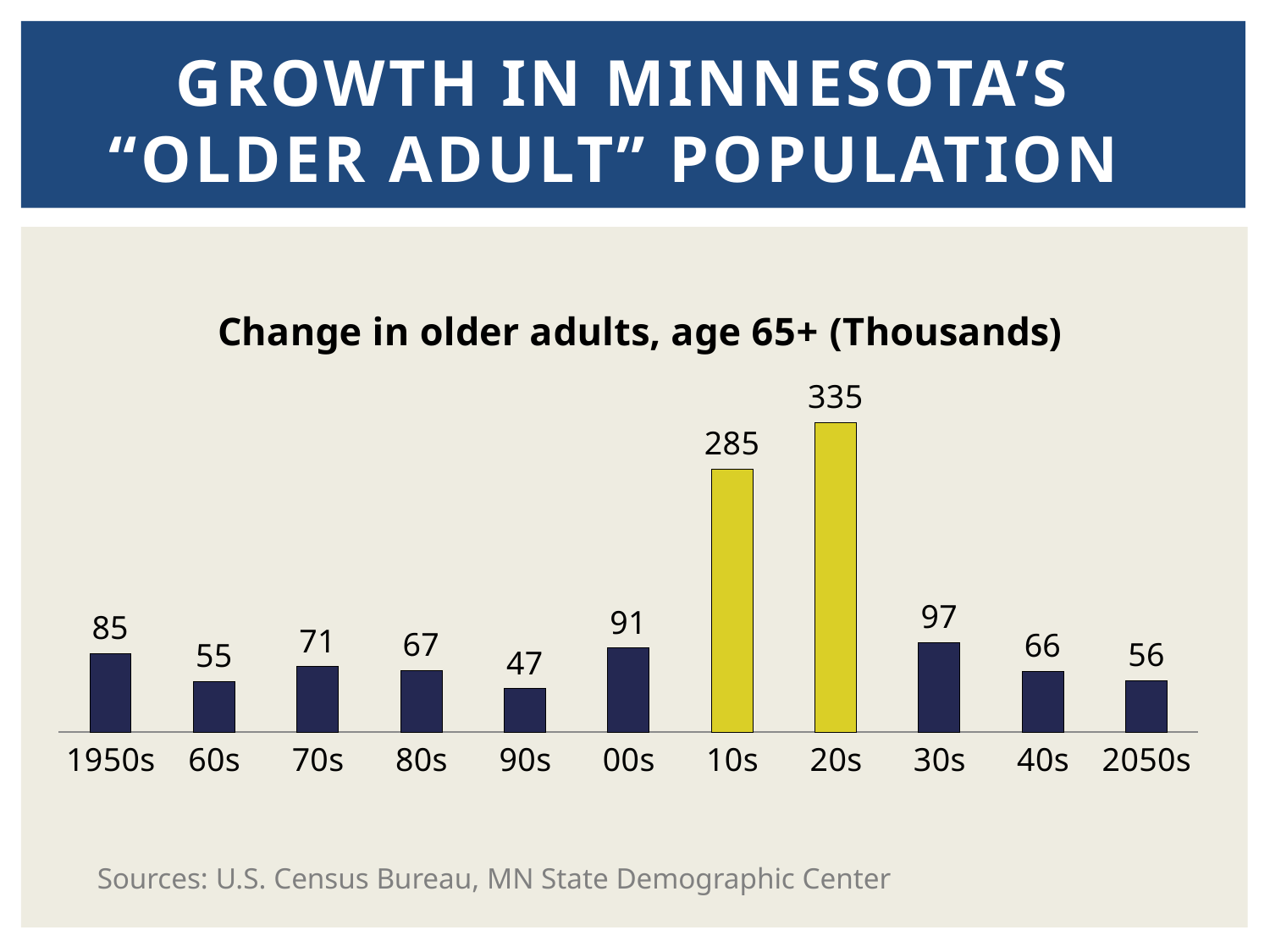
What is the difference between the values for the 20s and the 10s? 50 What is the value for the 90s? 47 What is the title of the chart? Change in older adults, age 65+ (Thousands) What is the difference between the values for the 30s and the 40s? 31 What kind of chart is shown on the slide? Bar chart What is the value for the 1950s? 85 What is the value for the 2050s? 56 Which decade has the highest value? 20s Which decade has the lowest value? 90s How many decades are shown on the x axis? 11 Which is larger, the value for the 70s or the value for the 80s? 70s Which two bars are coloured yellow instead of dark blue? 10s and 20s